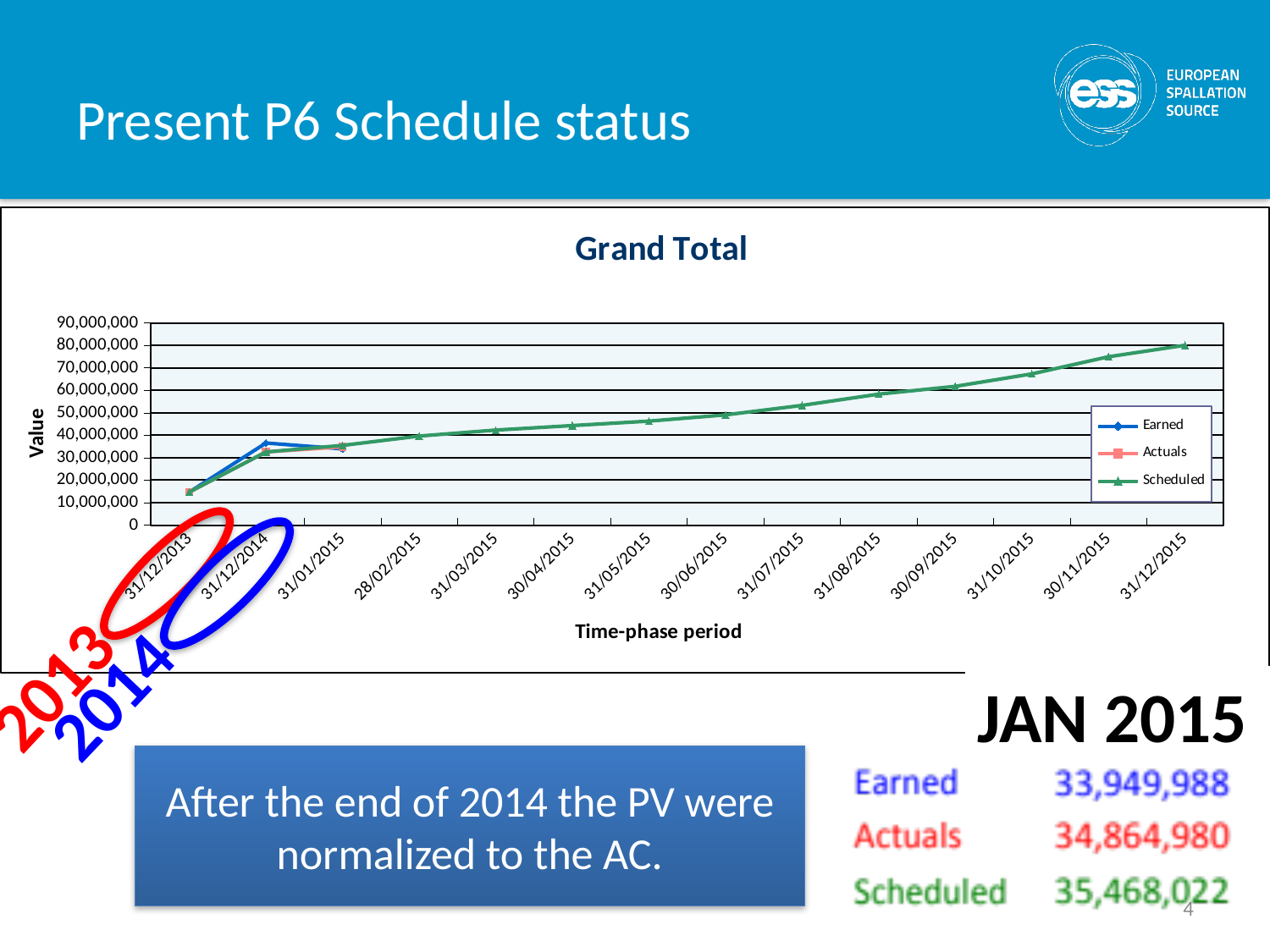
What kind of chart is shown on the slide? line chart At 31/12/2014, which series has the higher value, Earned or Scheduled? Earned What is the title of the chart? Grand Total Is the Scheduled value for 31/07/2015 greater or less than 50,000,000? greater What is the label of the x axis of the chart? Time-phase period Does the Scheduled series rise or fall from 31/12/2013 to 31/12/2015? rise How many series does the chart legend list? 3 At which time-phase period is the Scheduled series at its lowest value? 31/12/2013 At which time-phase period does the Scheduled series reach its highest value? 31/12/2015 Is the Scheduled value for 31/12/2013 greater or less than 20,000,000? less Is the Scheduled value for 31/10/2015 greater or less than 70,000,000? less How many time-phase periods are shown on the x axis of the chart? 14